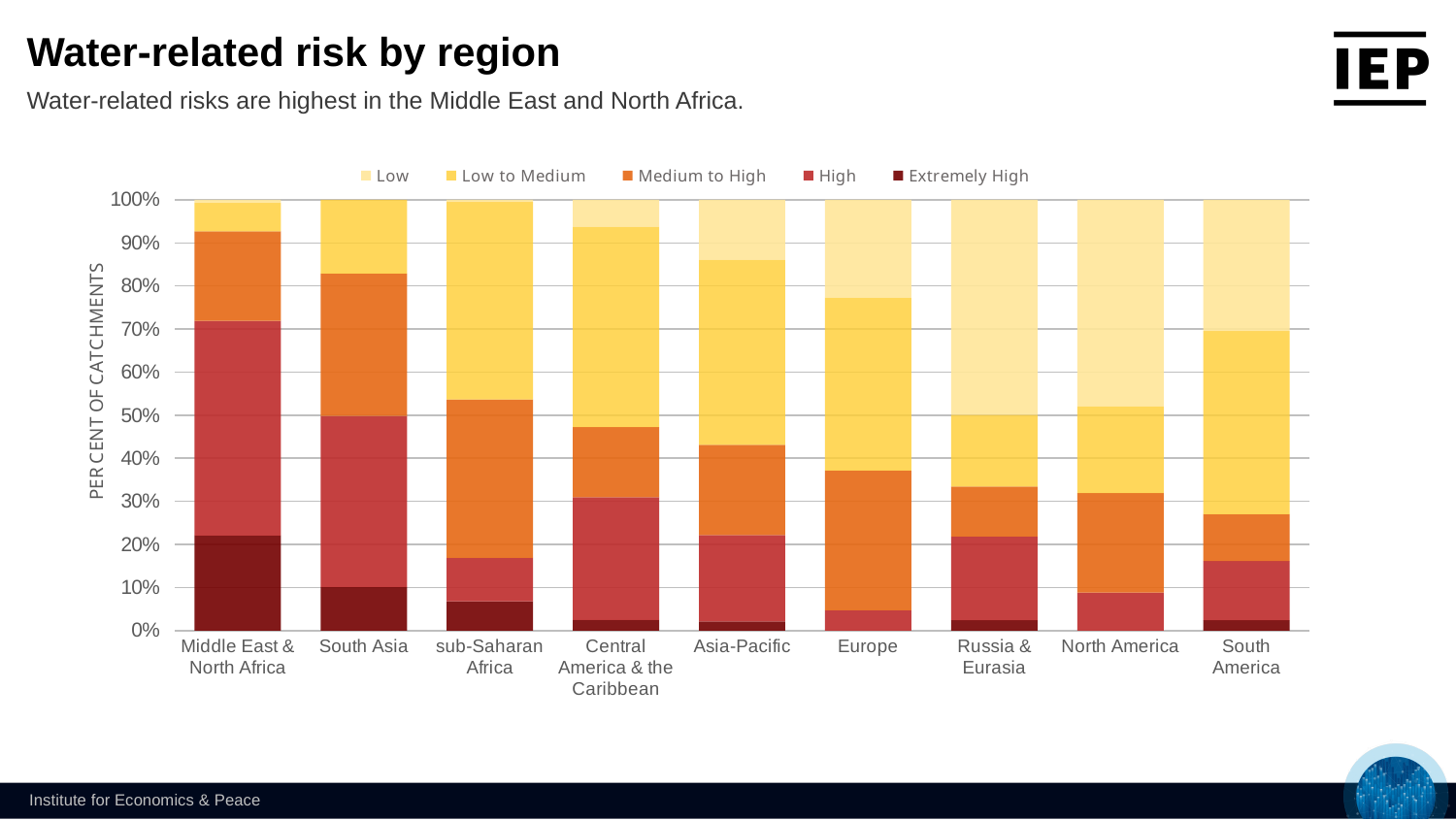
Is the High share for Europe greater or less than 10%? less Is the Extremely High share for Middle East & North Africa greater or less than 10%? greater Is the Extremely High share larger for South Asia or for sub-Saharan Africa? South Asia What is the label on the chart's vertical axis? PER CENT OF CATCHMENTS What kind of chart is shown on the slide? Stacked bar chart How many regions are shown on the x axis of the chart? 9 Is the Extremely High share for South Asia greater or less than 20%? less Which region has the smallest Low share of catchments? South Asia Which region has the largest Extremely High share of catchments? Middle East & North Africa What does each stacked bar in the chart total? 100% How many series does the chart's legend list? 5 Which region has the largest High share of catchments? Middle East & North Africa